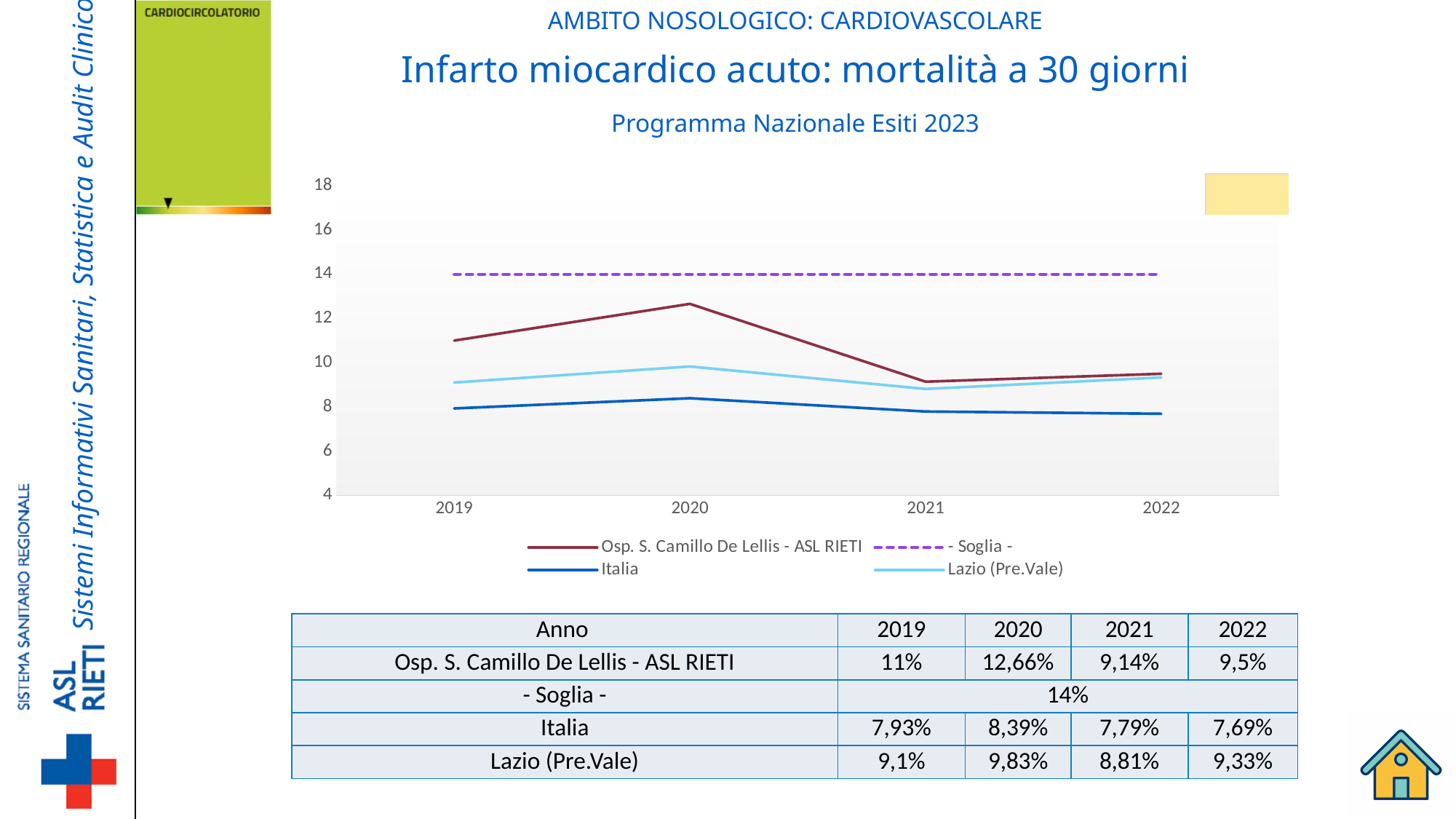
What is the value for Osp. S. Camillo De Lellis - ASL RIETI in 2020? 12,66% How many series does the chart legend list? 4 In which year is the value for Osp. S. Camillo De Lellis - ASL RIETI highest? 2020 In which year is the value for Italia lowest? 2022 What is the difference between Osp. S. Camillo De Lellis - ASL RIETI and Lazio (Pre.Vale) in 2020? 2,83% What is the value of the - Soglia - line? 14% Does the Italia line rise or fall from 2020 to 2022? fall How many years are plotted along the x axis of the chart? 4 What kind of chart is shown on the slide? line chart What is the value for Italia in 2022? 7,69% Is the value for Osp. S. Camillo De Lellis - ASL RIETI in 2019 greater or less than 10? greater In 2021, which is larger: Osp. S. Camillo De Lellis - ASL RIETI or Lazio (Pre.Vale)? Osp. S. Camillo De Lellis - ASL RIETI